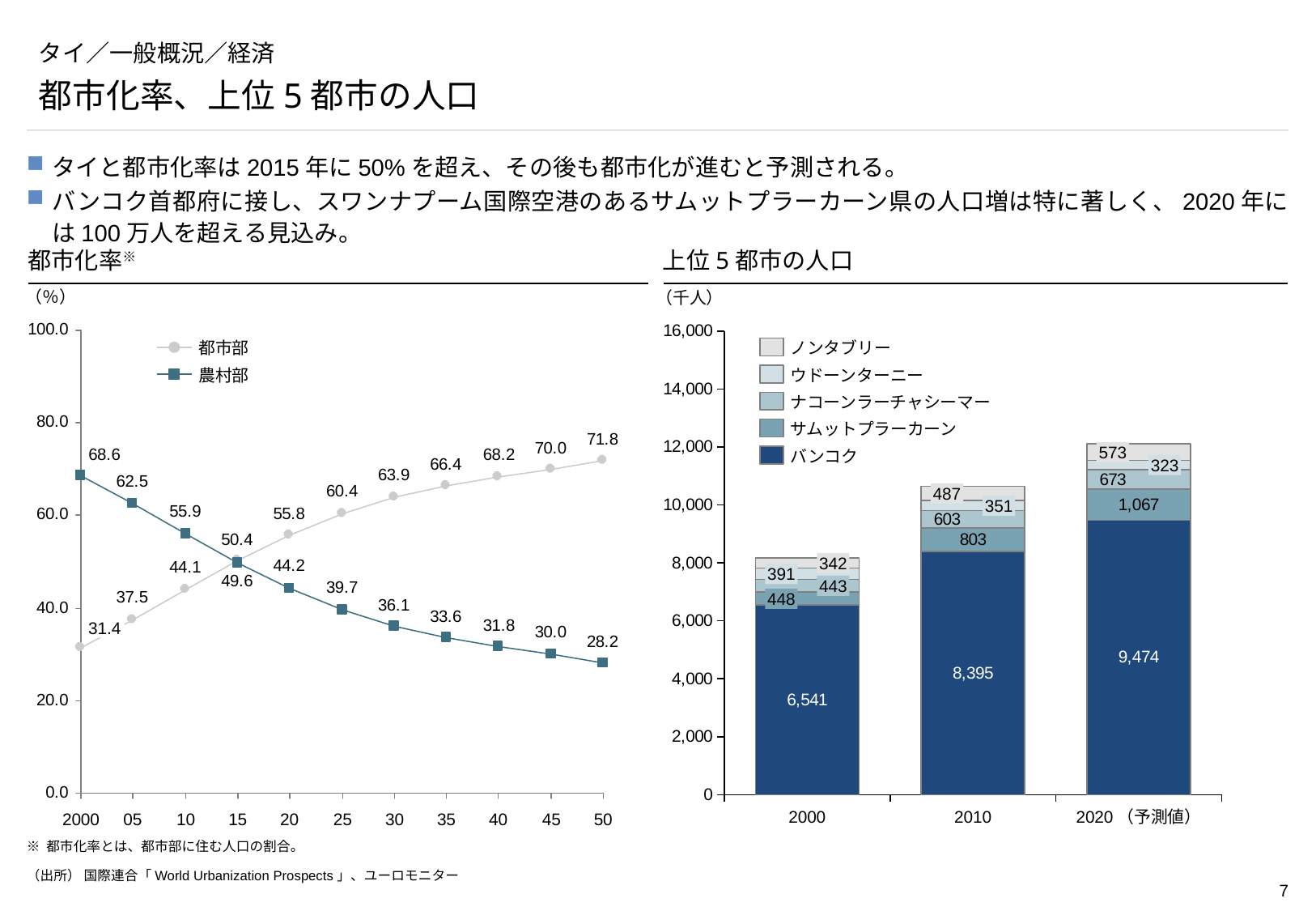
What kind of chart is the 都市化率 chart on the left? line chart In the 都市化率 chart, at which year does 都市部 reach its highest value? 50 In the 上位5都市の人口 chart, what is the total of the stacked bar for 2010? 10,639 In the 上位5都市の人口 chart, what is the value for サムットプラーカーン in 2020 (予測値)? 1,067 In the 都市化率 chart, what is the value for 都市部 in 2015 (15)? 50.4 In the 上位5都市の人口 chart for 2010, which is larger: サムットプラーカーン or ナコーンラーチャシーマー? サムットプラーカーン How many series does the legend of the 上位5都市の人口 chart list? 5 In the 都市化率 chart, what is the value for 農村部 in 2000? 68.6 What kind of chart is the 上位5都市の人口 chart on the right? bar chart In the 上位5都市の人口 chart, what is the value for バンコク in 2010? 8,395 In the 上位5都市の人口 chart, by how much does the バンコク value in 2020 (予測値) exceed the バンコク value in 2000? 2,933 In the 都市化率 chart, does the 農村部 series rise or fall from 2000 to 50? fall